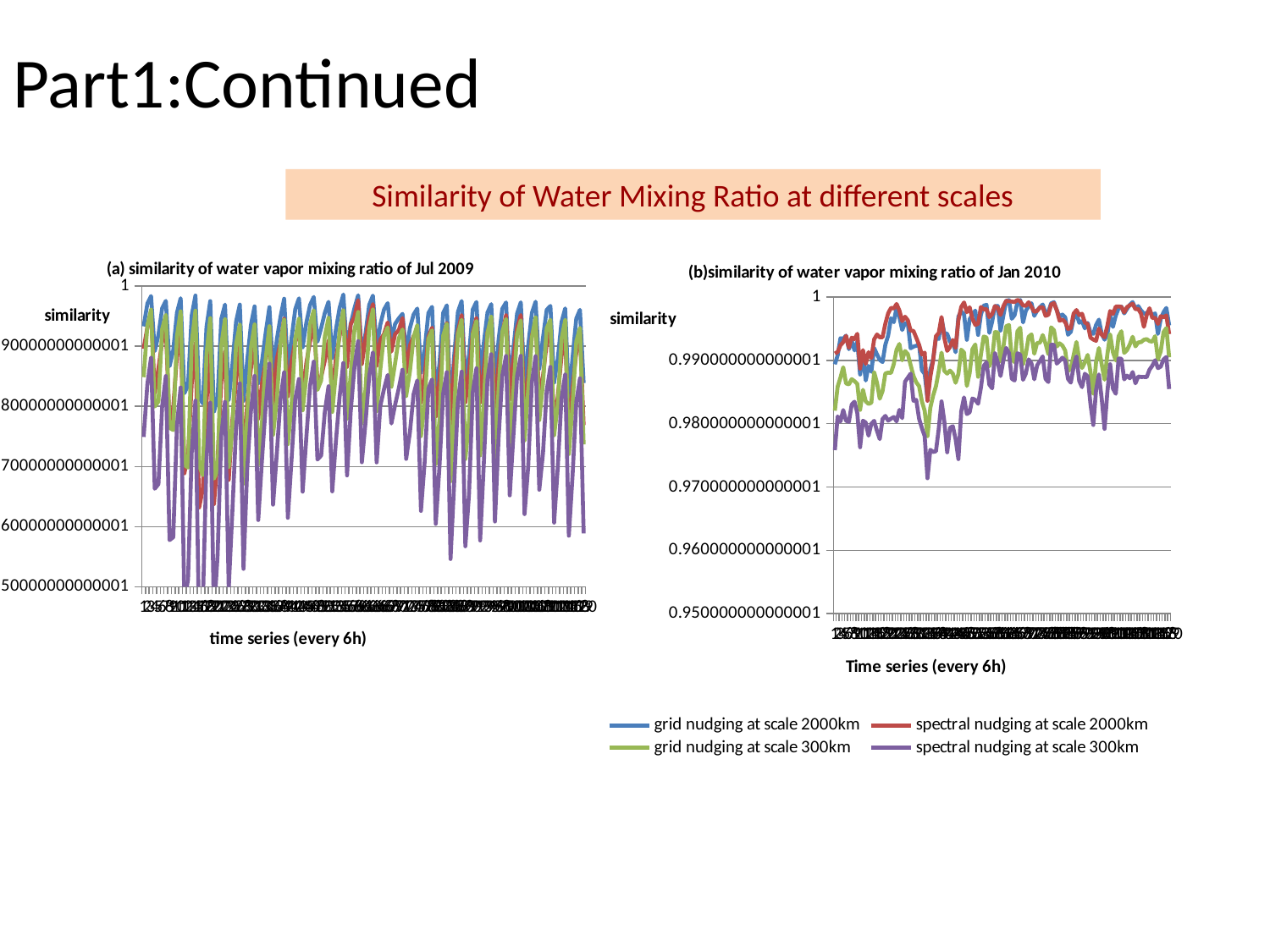
What kind of chart is "(b)similarity of water vapor mixing ratio of Jan 2010"? line chart In chart (b) similarity of water vapor mixing ratio of Jan 2010, what is the lowest value shown on the y axis? 0.950000000000001 How many series does the legend list for the charts on the slide? 4 In chart (b) similarity of water vapor mixing ratio of Jan 2010, is the lowest value of spectral nudging at scale 300km greater or less than 0.980000000000001? less In chart (b) similarity of water vapor mixing ratio of Jan 2010, is the lowest value of grid nudging at scale 2000km greater or less than 0.980000000000001? greater What is the x-axis title of chart (b) similarity of water vapor mixing ratio of Jan 2010? Time series (every 6h) In chart (b) similarity of water vapor mixing ratio of Jan 2010, which series has the lowest values overall? spectral nudging at scale 300km In chart (b) similarity of water vapor mixing ratio of Jan 2010, which series is plotted in purple? spectral nudging at scale 300km What kind of chart is "(a) similarity of water vapor mixing ratio of Jul 2009"? line chart In chart (a) similarity of water vapor mixing ratio of Jul 2009, which series drops to the lowest values? spectral nudging at scale 300km